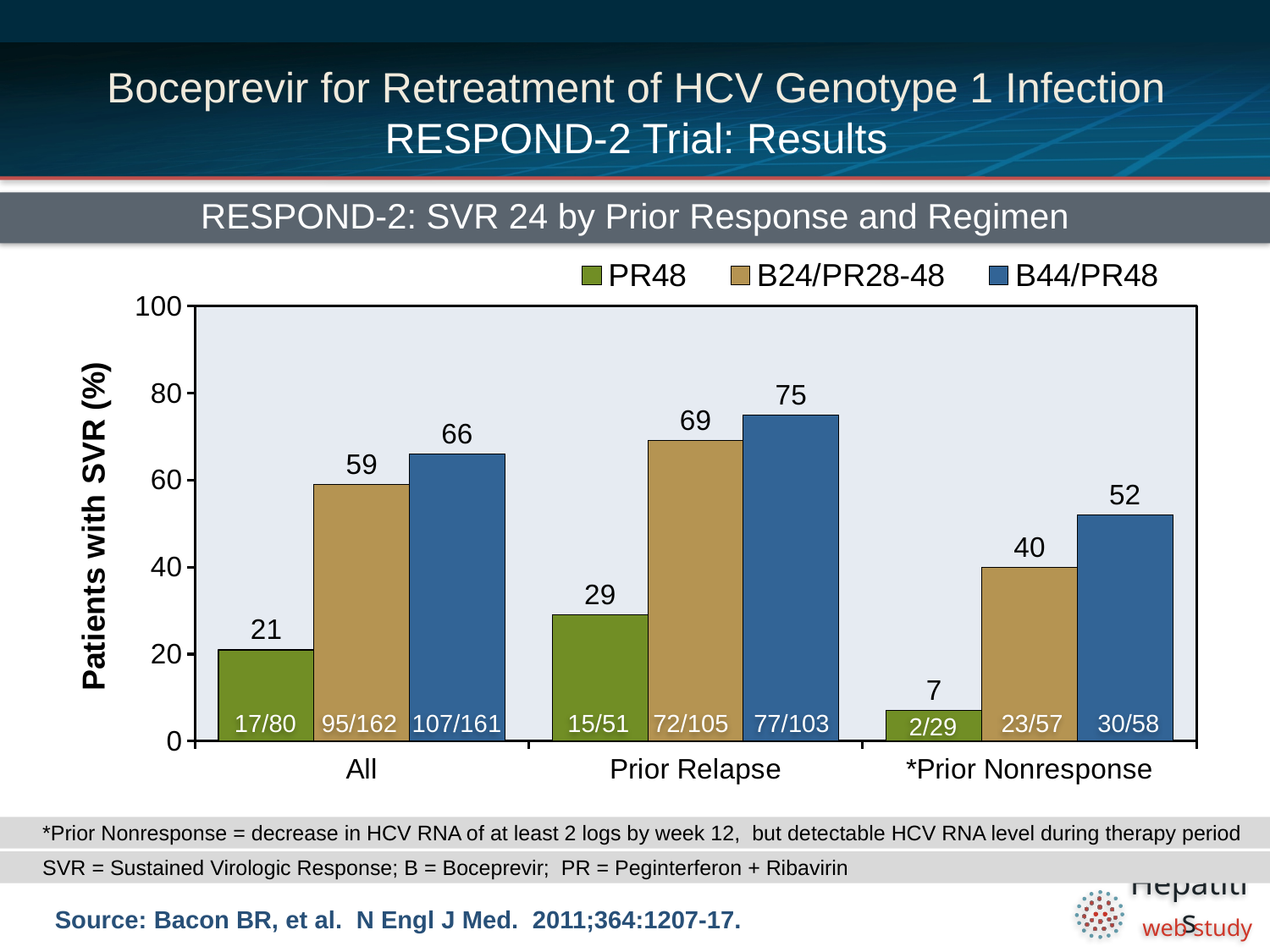
What is the SVR rate for PR48 in the All group? 21 Which regimen has the lowest SVR rate in the Prior Relapse group? PR48 What is the difference in SVR rate between B44/PR48 and PR48 in the All group? 45 Which regimen has the highest SVR rate in the Prior Nonresponse group? B44/PR48 How many prior-response groups are shown on the x axis? 3 What is the SVR rate for the B44/PR48 regimen in the Prior Relapse group? 75 What is the label of the y axis? Patients with SVR (%) What type of chart is shown? Bar chart What is the SVR rate for B24/PR28-48 in the Prior Nonresponse group? 40 How many regimens does the legend list? 3 Which is larger: the B24/PR28-48 SVR rate in the Prior Relapse group or the B44/PR48 SVR rate in the All group? B24/PR28-48 in Prior Relapse What is the difference in SVR rate between B24/PR28-48 and PR48 in the Prior Nonresponse group? 33